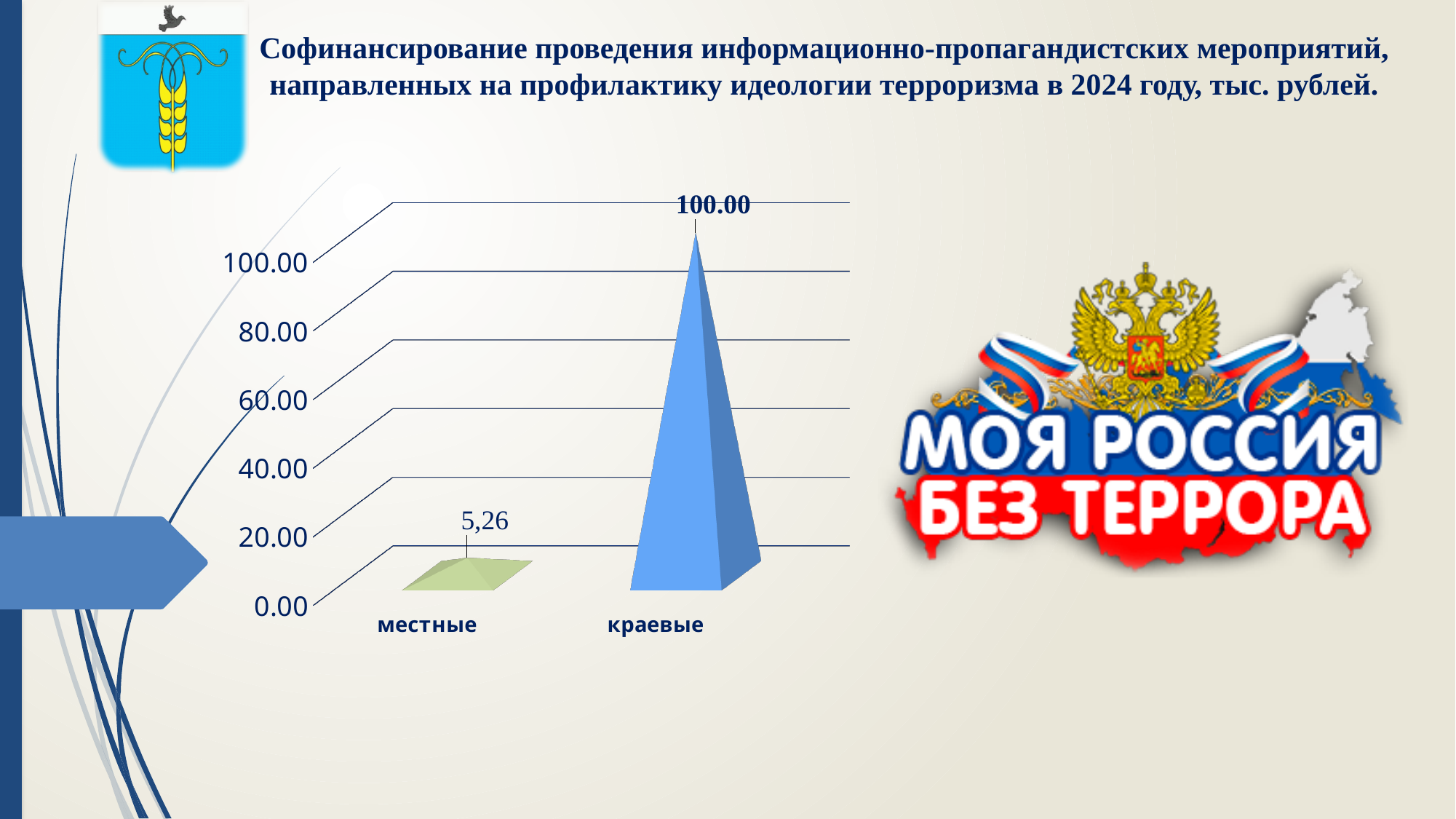
What is the value for краевые? 100.00 Which category has the lowest value? местные What kind of chart is shown on the slide? bar chart Which is larger, the value for местные or the value for краевые? краевые What is the difference between the value for краевые and the value for местные? 94.74 In what units are the values on the chart given, according to the slide title? тыс. рублей Which category has the highest value? краевые Is the value for местные greater or less than 20.00? less Is the value for краевые greater or less than 80.00? greater How many categories are shown on the chart? 2 What is the value for местные? 5,26 What is the highest value shown on the vertical axis of the chart? 100.00